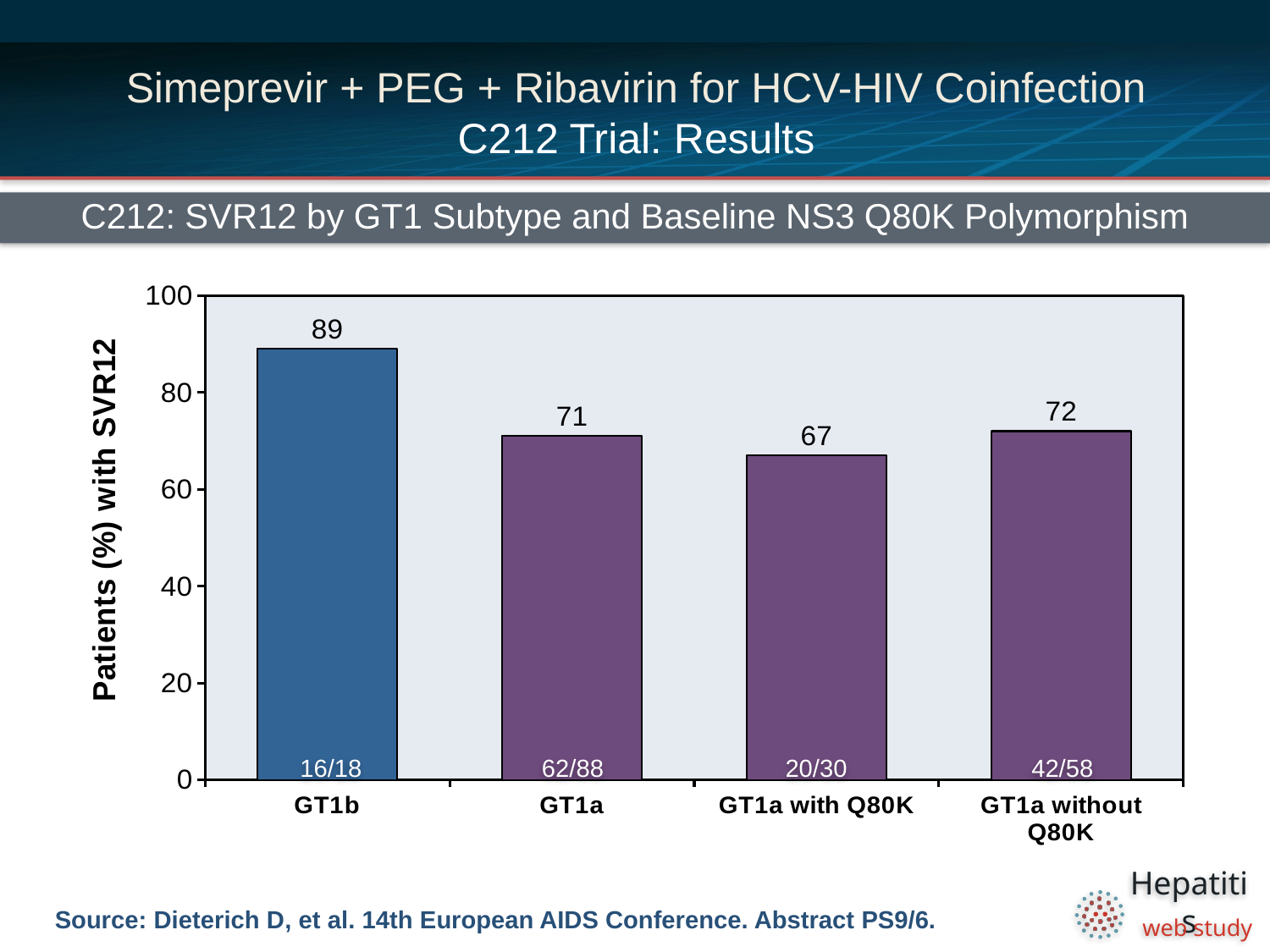
Which has a higher SVR12 rate, GT1a with Q80K or GT1a without Q80K? GT1a without Q80K What is the difference in SVR12 rate between GT1a without Q80K and GT1a with Q80K? 5 What fraction of patients is shown inside the GT1a bar? 62/88 Is the value for GT1b greater or less than 80? greater Which category has the highest SVR12 rate? GT1b Which category has the lowest SVR12 rate? GT1a with Q80K What is the SVR12 rate (%) for GT1b? 89 What is the difference in SVR12 rate between GT1b and GT1a? 18 What is the SVR12 rate (%) for GT1a with Q80K? 67 What kind of chart is shown on the slide? Bar chart What is the SVR12 rate (%) for GT1a without Q80K? 72 How many categories are shown on the x axis? 4